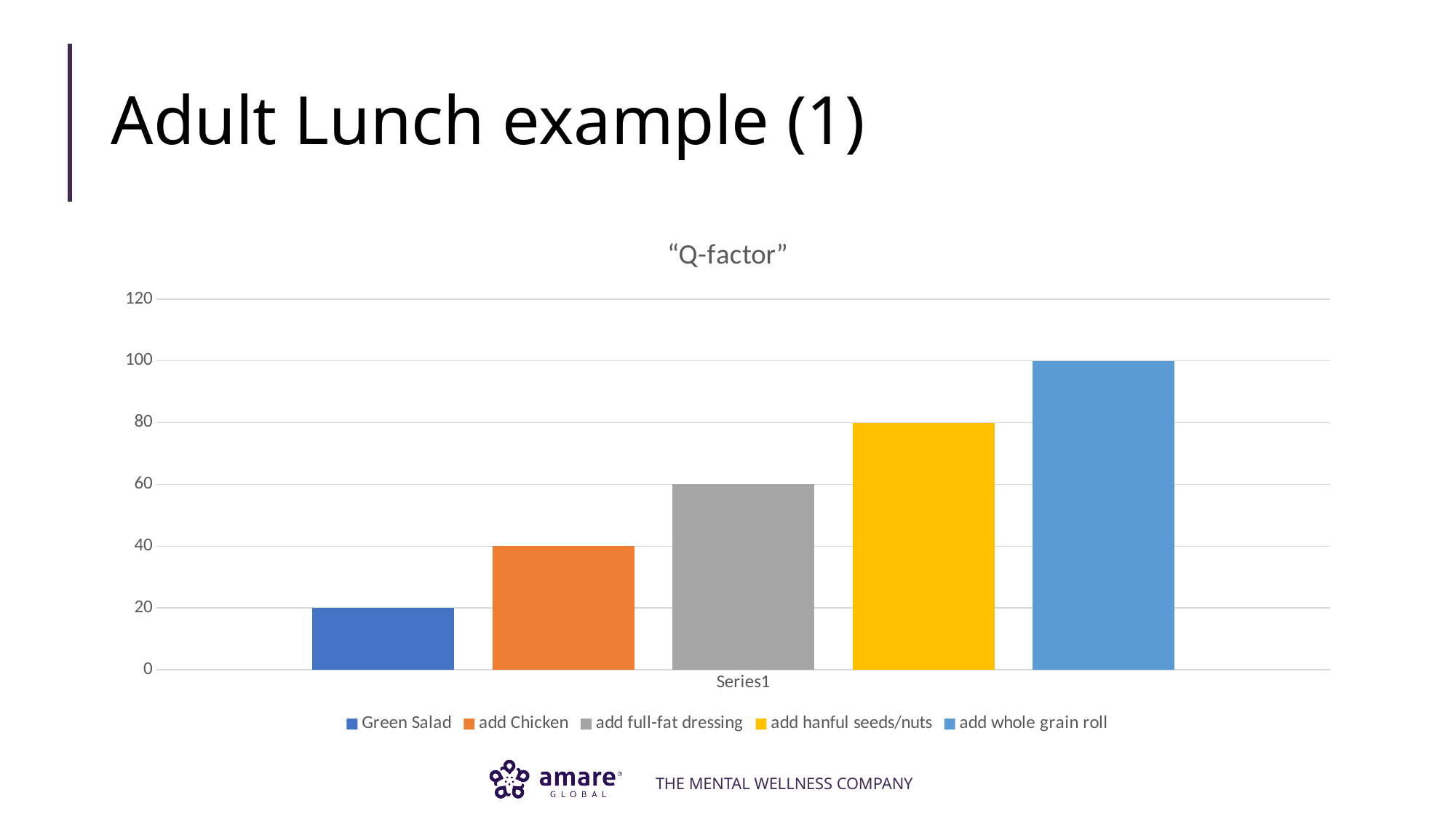
What is the value for add full-fat dressing in the "Q-factor" chart? 60 What kind of chart is shown on the slide? bar chart How many bars are plotted in the "Q-factor" chart? 5 Which is larger, the value for add hanful seeds/nuts or the value for add Chicken? add hanful seeds/nuts What is the value for Green Salad in the "Q-factor" chart? 20 Which legend entry has the highest value in the "Q-factor" chart? add whole grain roll What is the difference between the values for add whole grain roll and Green Salad? 80 What is the value for add Chicken in the "Q-factor" chart? 40 How many entries does the legend of the "Q-factor" chart list? 5 Do the bar values rise or fall from left to right in the "Q-factor" chart? rise What is the value for add whole grain roll in the "Q-factor" chart? 100 Which legend entry has the lowest value in the "Q-factor" chart? Green Salad